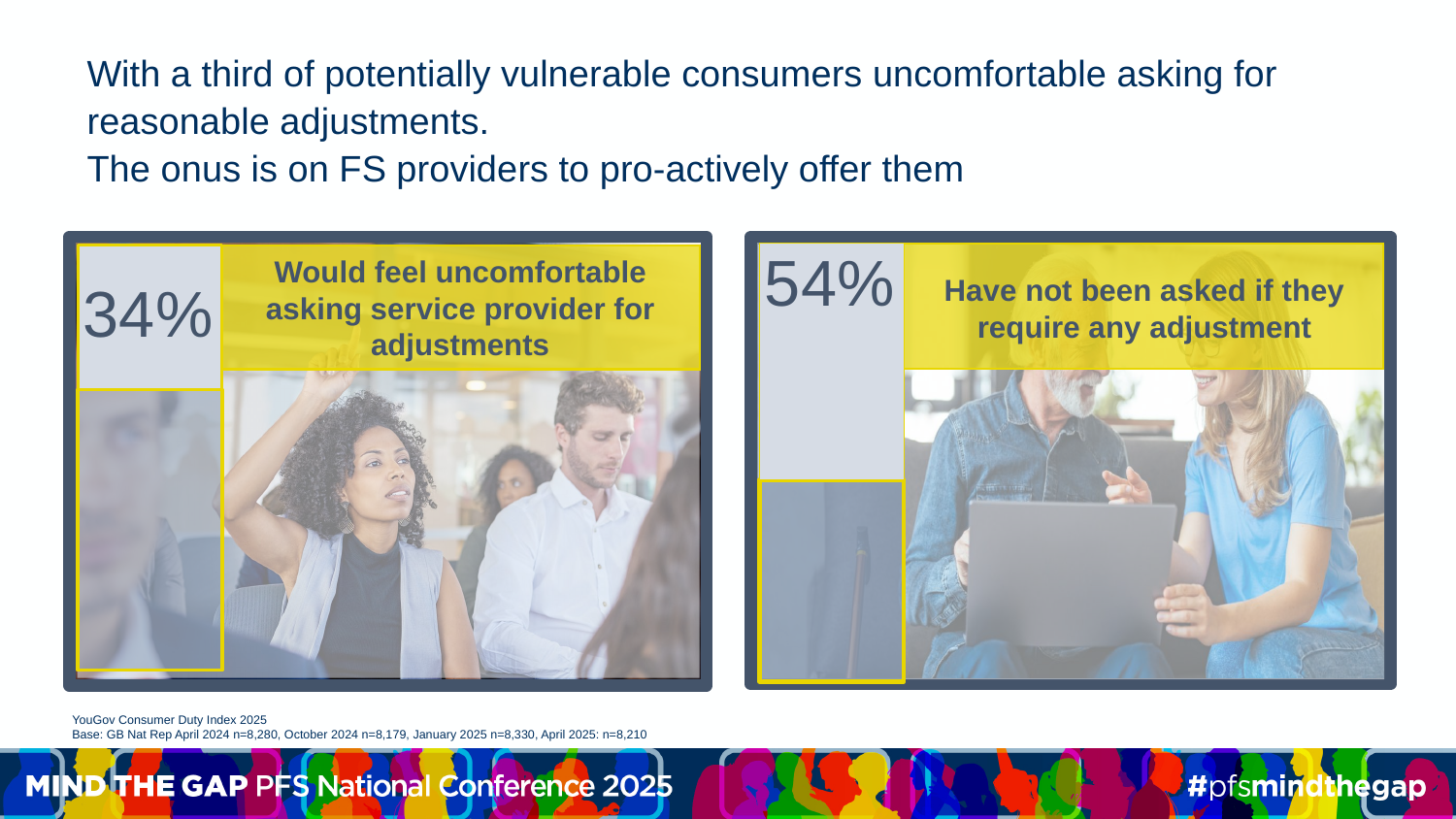
Which is larger: the share who would feel uncomfortable asking for adjustments or the share who have not been asked if they require any adjustment? Have not been asked if they require any adjustment Which statistic is shown in the right-hand panel? 54% What is the base sample size given for April 2025? n=8,210 What percentage of potentially vulnerable consumers would feel uncomfortable asking a service provider for adjustments? 34% What percentage have not been asked if they require any adjustment? 54% What is the difference in percentage points between the 54% who have not been asked about adjustments and the 34% who would feel uncomfortable asking? 20 percentage points Which statistic is shown in the left-hand panel? 34% What is the source cited for the statistics on the slide? YouGov Consumer Duty Index 2025 How many statistic panels are shown on the slide? 2